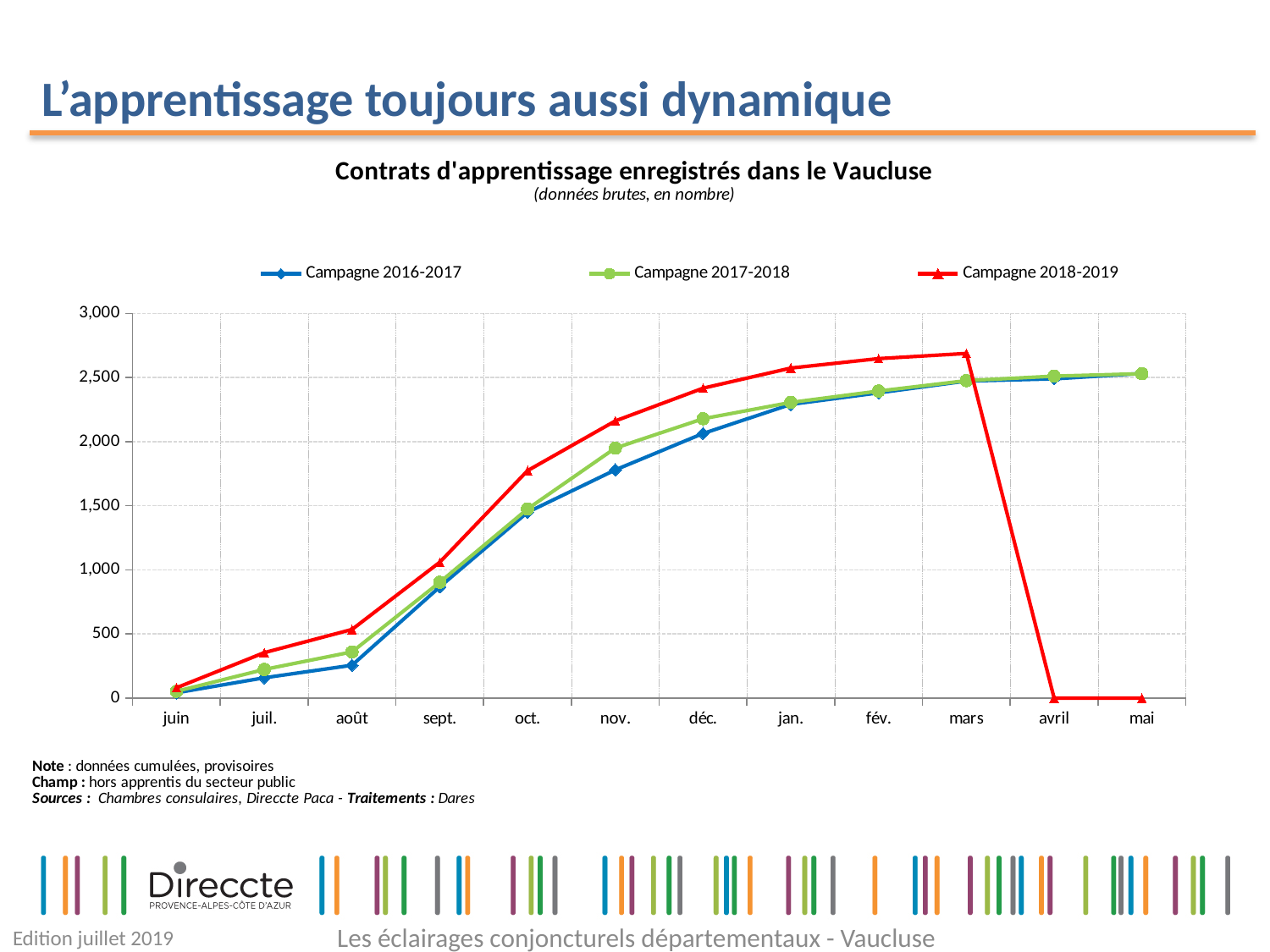
In nov., which is larger: Campagne 2018-2019 or Campagne 2016-2017? Campagne 2018-2019 Is the value for Campagne 2018-2019 in oct. greater or less than 1,500? greater What is the title of the chart? Contrats d'apprentissage enregistrés dans le Vaucluse How many months are shown along the x axis? 12 Does the Campagne 2017-2018 series rise or fall from juin to mai? rise Is the value for Campagne 2016-2017 in août greater or less than 500? less In août, which is larger: Campagne 2017-2018 or Campagne 2016-2017? Campagne 2017-2018 How many series does the legend list? 3 Is the value for Campagne 2017-2018 in déc. greater or less than 2,000? greater Which series is drawn in red with triangle markers? Campagne 2018-2019 What kind of chart is shown on the slide? line chart